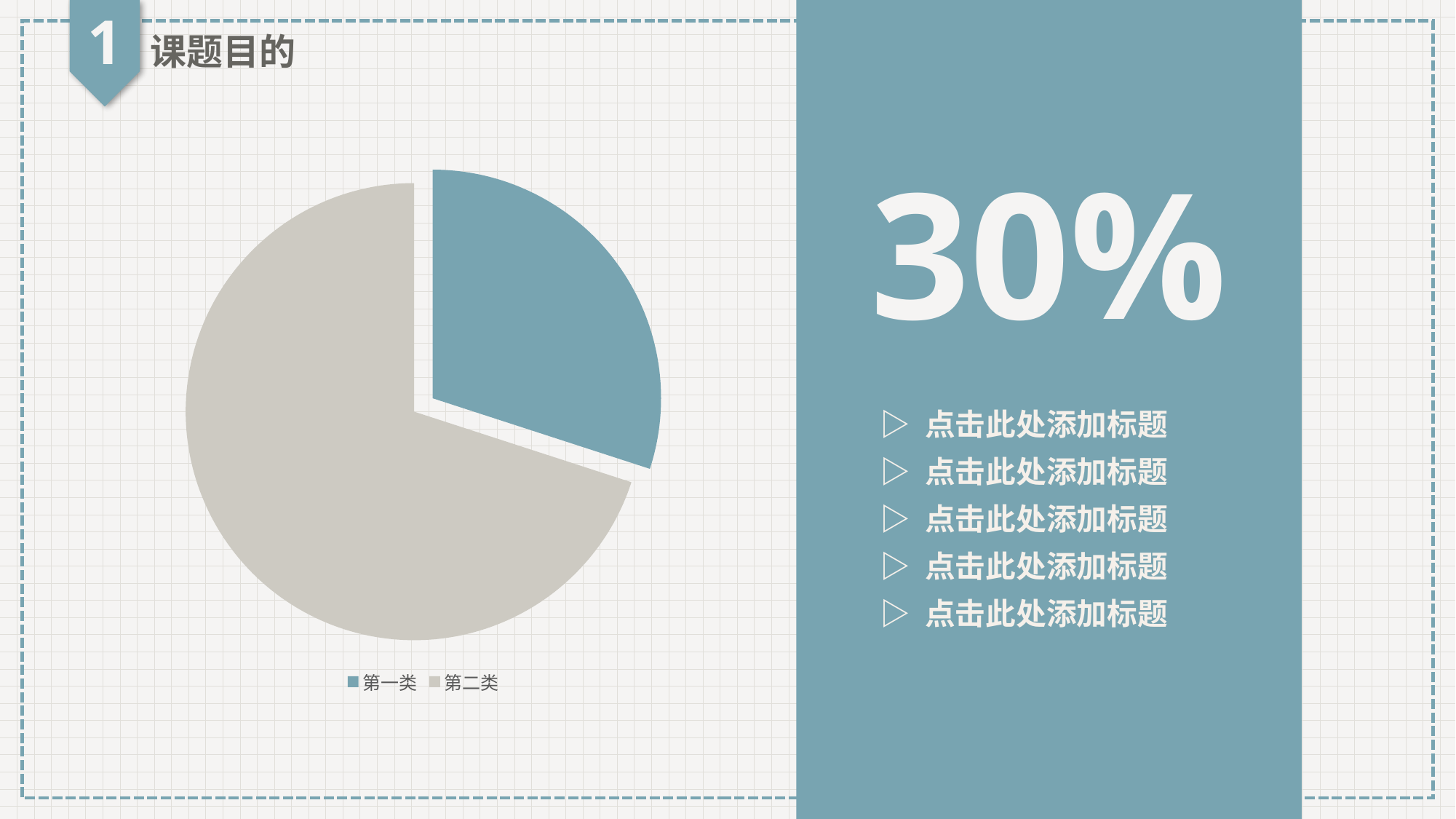
Which is larger in the pie chart, 第一类 or 第二类? 第二类 How many entries does the legend of the pie chart list? 2 How many slices does the pie chart have? 2 Which category has the largest slice of the pie chart? 第二类 What colour is the slice for 第一类 in the pie chart? blue Which slice is pulled out (separated) from the rest of the pie chart? 第一类 Which category has the smallest slice of the pie chart? 第一类 Does the slice for 第一类 take up more or less than half of the pie? less Does the slice for 第二类 take up more or less than half of the pie? more What kind of chart is shown on the slide? pie chart